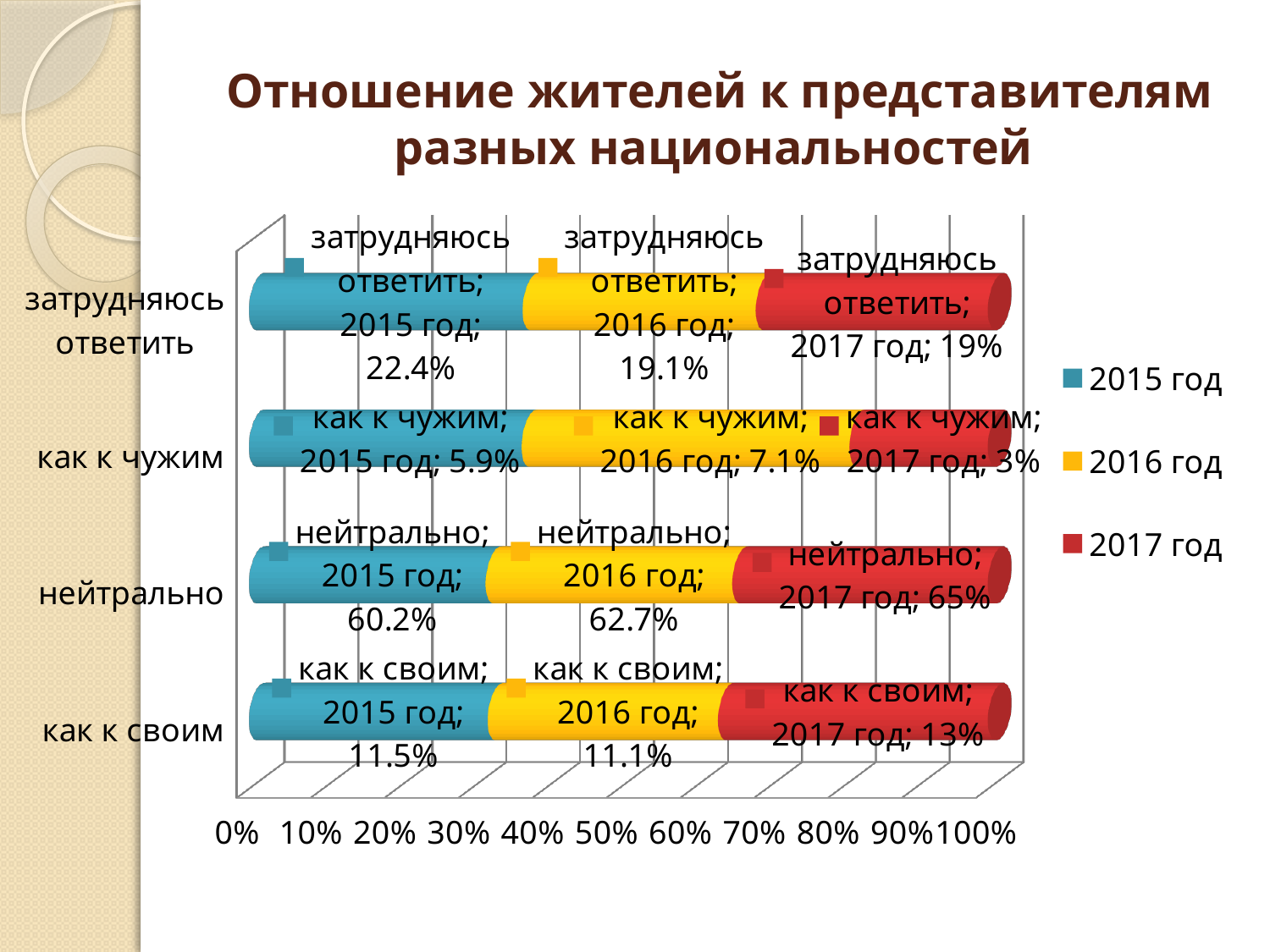
What is the difference between the 2017 год and 2015 год values for «нейтрально»? 4.8 percentage points What is the value for «затрудняюсь ответить» in 2015 год? 22.4% Which category has the highest value in 2017 год? нейтрально What is the value for «как к своим» in 2016 год? 11.1% What is the value for «нейтрально» in 2017 год? 65% Which is larger for «как к своим»: the 2015 год value or the 2017 год value? 2017 год What is the title of the slide? Отношение жителей к представителям разных национальностей What kind of chart is shown on the slide? bar chart What is the value for «как к чужим» in 2016 год? 7.1% Which category has the lowest value in 2015 год? как к чужим How many categories are shown on the chart? 4 How many series does the legend list? 3